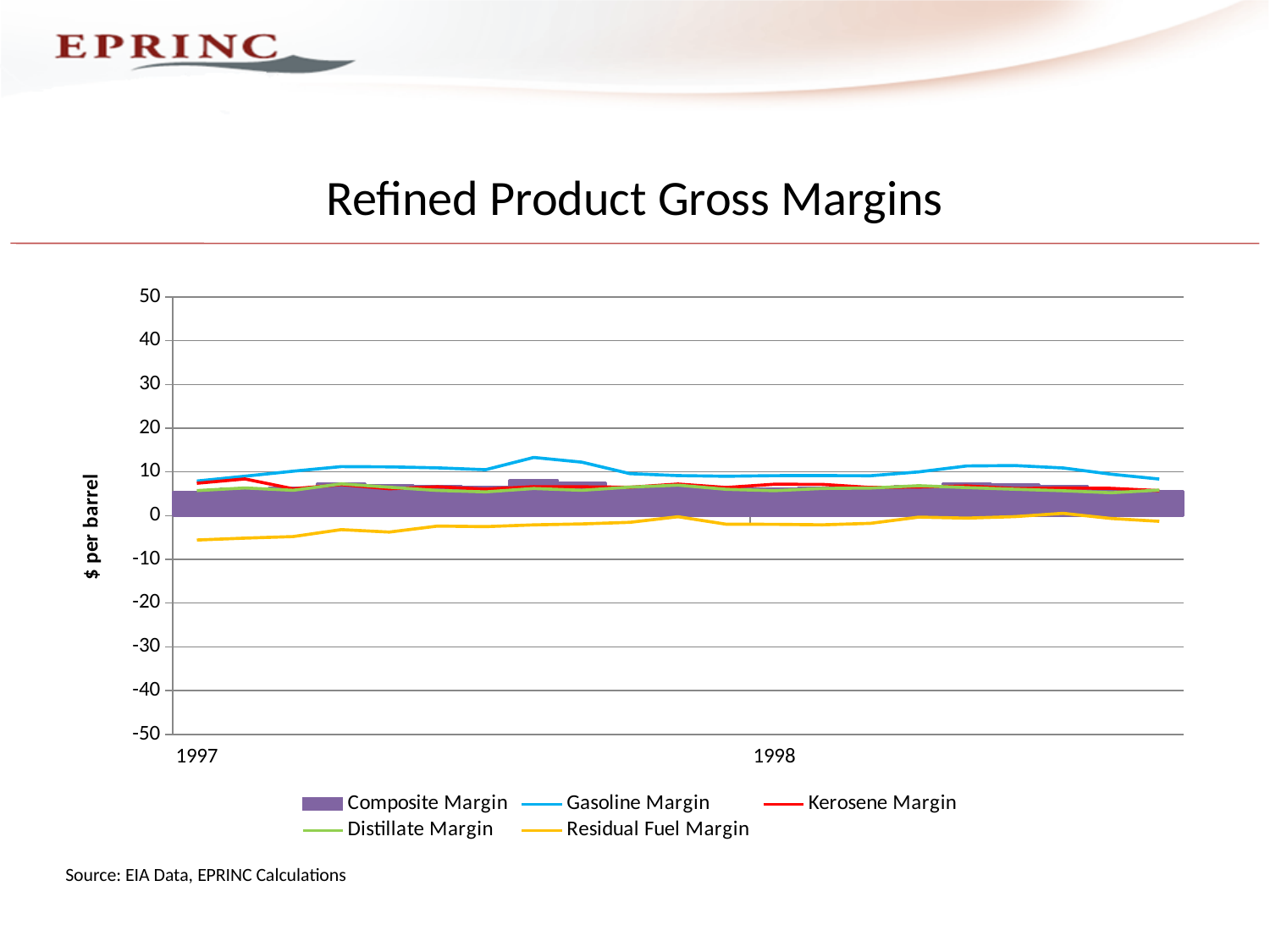
Does the Residual Fuel Margin generally rise or fall from the start of 1997 to the end of 1998? rise Which is larger at the start of 1997, the Gasoline Margin or the Residual Fuel Margin? Gasoline Margin Is the highest point of the Gasoline Margin line greater or less than 10? greater Is the Residual Fuel Margin at the start of 1997 greater or less than 0? less How many series does the chart legend list? 5 What is the title of the chart? Refined Product Gross Margins Which series is highest across the whole chart? Gasoline Margin What are the two years labelled on the horizontal axis? 1997 and 1998 Which series stays lowest across the whole chart? Residual Fuel Margin What is the label on the vertical axis of the chart? $ per barrel Is the Composite Margin bar at the start of 1997 greater or less than 10? less Which series is plotted as bars rather than a line? Composite Margin